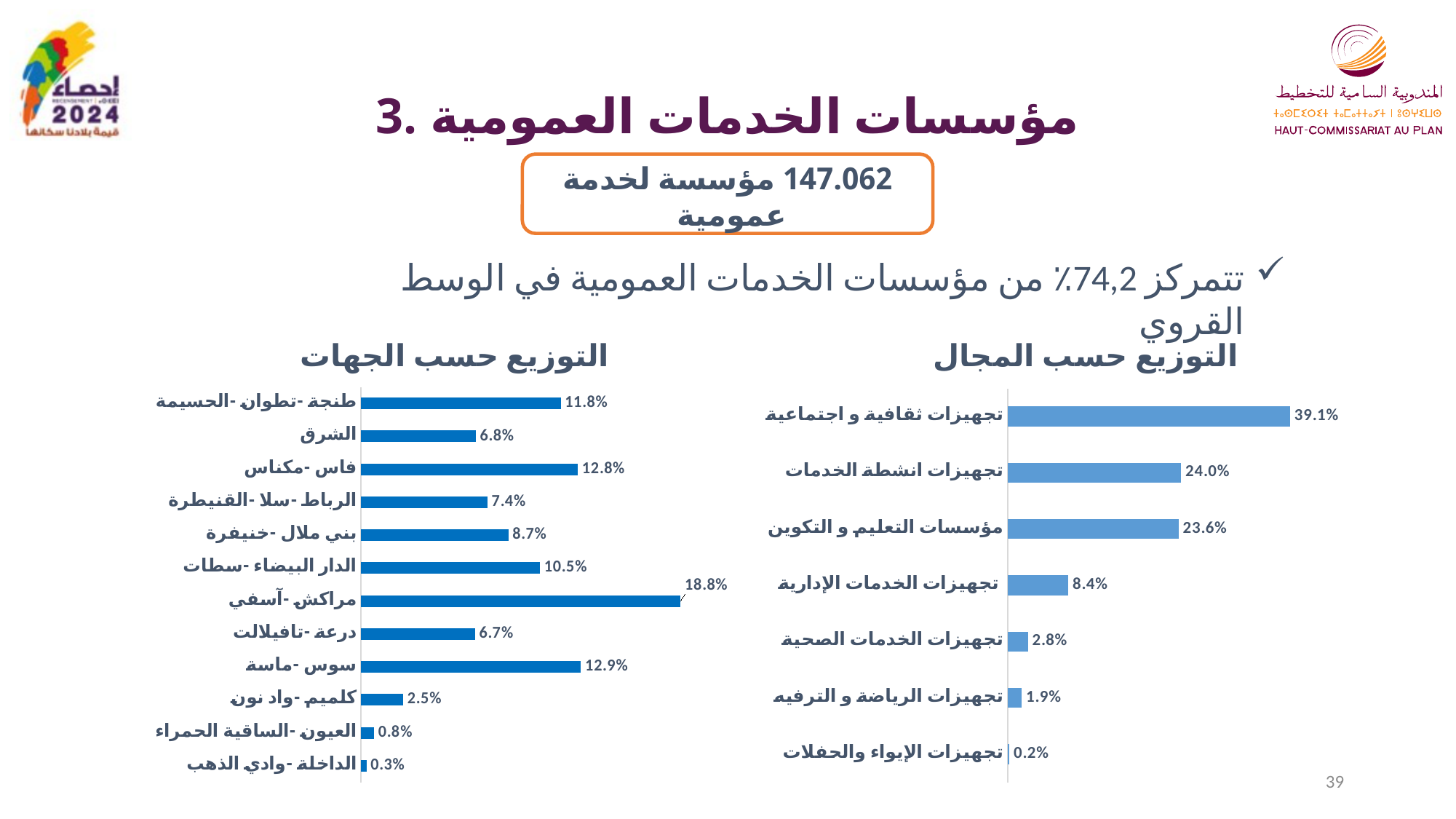
In the chart titled "التوزيع حسب المجال" (right chart), what is the value for "تجهيزات ثقافية و اجتماعية"? 39.1% In the chart titled "التوزيع حسب الجهات" (left chart), which is larger: "فاس -مكناس" or "طنجة -تطوان -الحسيمة"? فاس -مكناس In the chart titled "التوزيع حسب المجال" (right chart), what is the value for "تجهيزات الخدمات الصحية"? 2.8% In the chart titled "التوزيع حسب الجهات" (left chart), which region has the lowest value? الداخلة -وادي الذهب In the chart titled "التوزيع حسب المجال" (right chart), how many categories are shown? 7 In the chart titled "التوزيع حسب الجهات" (left chart), what is the difference between "مراكش -آسفي" and "سوس -ماسة"? 5.9% In the chart titled "التوزيع حسب الجهات" (left chart), which region has the highest value? مراكش -آسفي In the chart titled "التوزيع حسب المجال" (right chart), which category has the lowest value? تجهيزات الإيواء والحفلات In the chart titled "التوزيع حسب الجهات" (left chart), how many regions are shown? 12 In the chart titled "التوزيع حسب المجال" (right chart), what is the difference between "تجهيزات انشطة الخدمات" and "مؤسسات التعليم و التكوين"? 0.4% What type of chart is the chart titled "التوزيع حسب الجهات" (left chart)? Bar chart In the chart titled "التوزيع حسب الجهات" (left chart), what is the value for "الدار البيضاء -سطات"? 10.5%